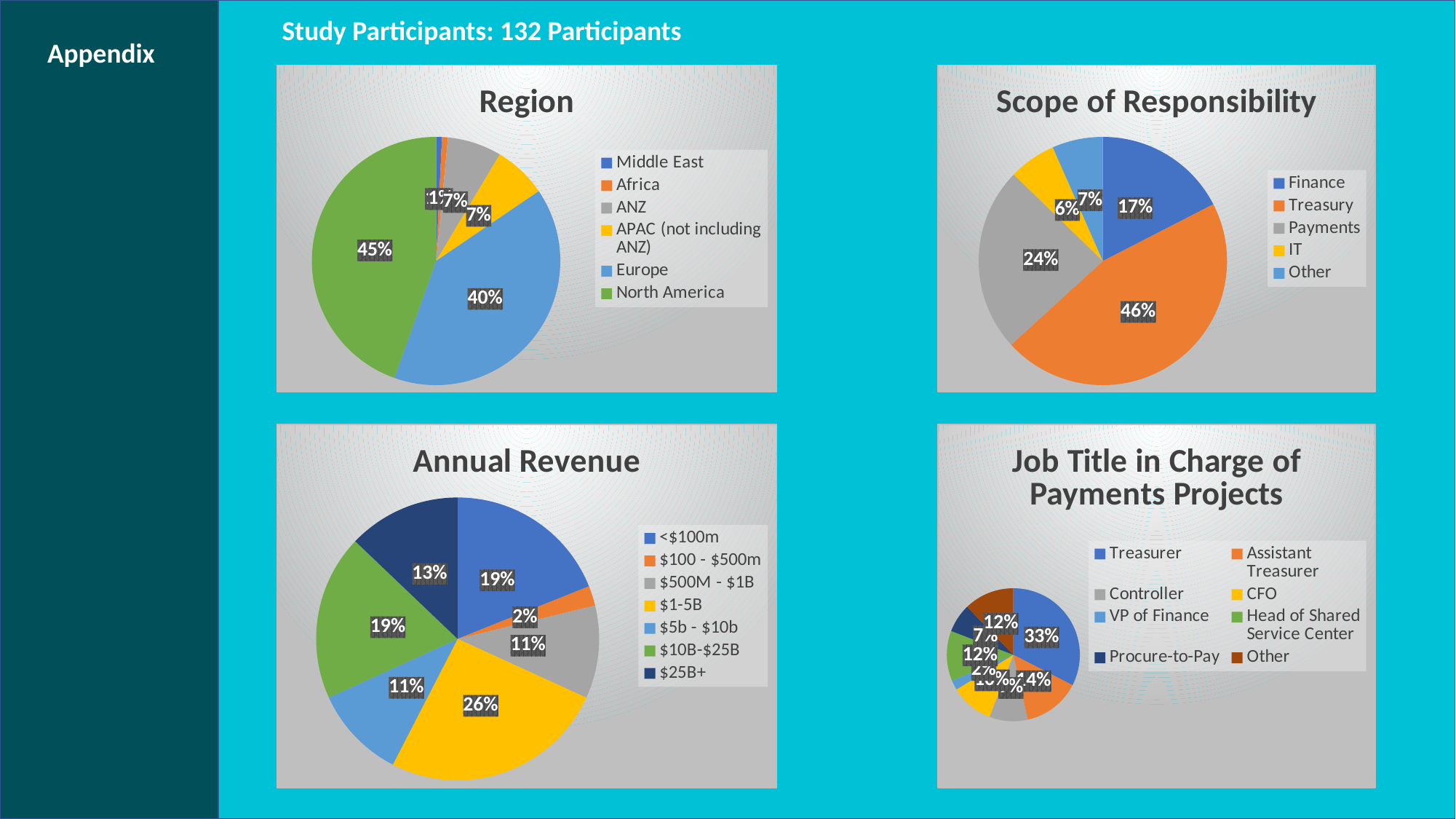
In the Scope of Responsibility chart, which category has the smallest share? IT In the Region chart, what percentage is North America? 45% In the Annual Revenue chart, which revenue band has the smallest share? $100 - $500m In the Region chart, which region has the largest share? North America In the Job Title in Charge of Payments Projects chart, what percentage is Treasurer? 33% In the Annual Revenue chart, which is larger, <$100m or $25B+? <$100m In the Annual Revenue chart, what percentage is $1-5B? 26% In the Region chart, how many regions does the legend list? 6 In the Scope of Responsibility chart, what percentage is Treasury? 46% What type of chart is the Scope of Responsibility chart? Pie chart In the Annual Revenue chart, how many revenue categories are shown? 7 In the Scope of Responsibility chart, what is the difference between Payments and Finance? 7%